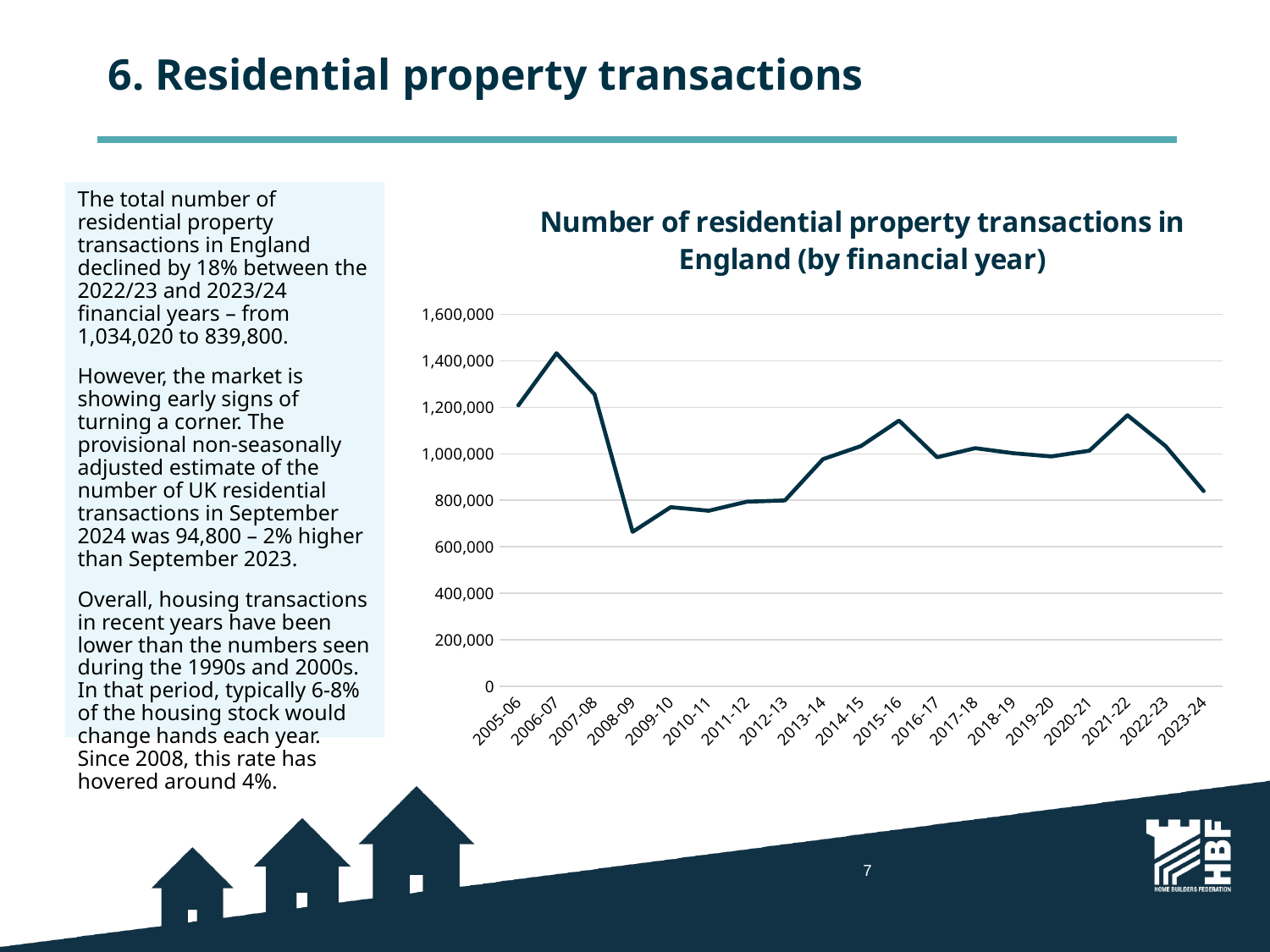
Do the values rise or fall from 2021-22 to 2023-24? Fall Is the value for 2021-22 greater or less than 1,000,000? greater Which financial year has the highest number of residential property transactions? 2006-07 What kind of chart is shown on the slide? Line chart What is the title of the chart? Number of residential property transactions in England (by financial year) Is the value for 2023-24 greater or less than 1,000,000? less Is the value for 2008-09 greater or less than 800,000? less Which is larger, the value for 2006-07 or the value for 2007-08? 2006-07 How many financial years are plotted on the chart? 19 Which is larger, the value for 2015-16 or the value for 2016-17? 2015-16 Which financial year has the lowest number of residential property transactions? 2008-09